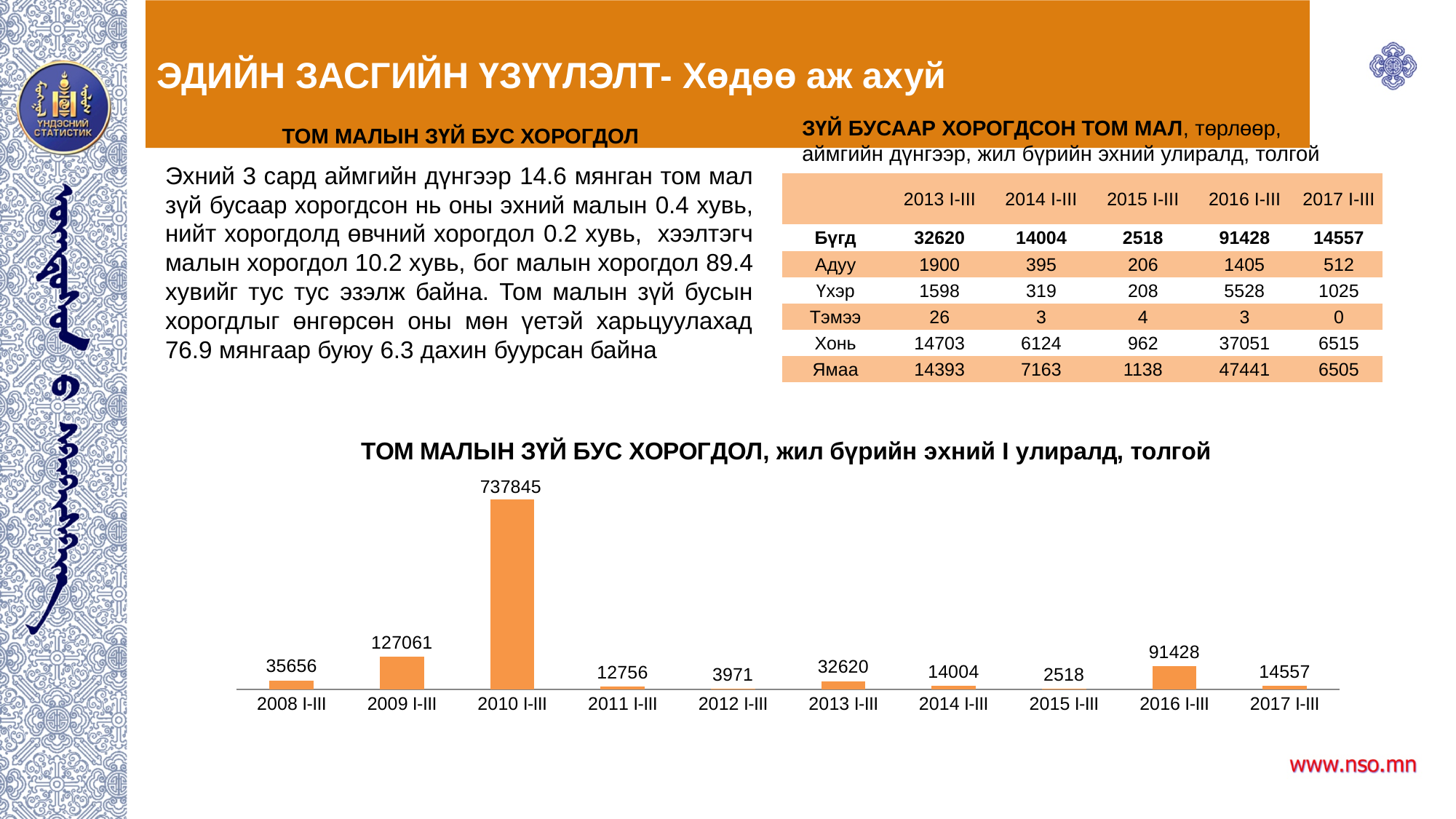
Does the value rise or fall from 2016 I-III to 2017 I-III in the bar chart? Fall What is the value for 2010 I-III in the bar chart? 737845 How many periods are shown on the x axis of the bar chart? 10 What is the value for 2016 I-III in the bar chart? 91428 Which period has the highest value in the bar chart? 2010 I-III What is the difference between the values for 2009 I-III and 2008 I-III in the bar chart? 91405 What kind of chart is shown at the bottom of the slide? Bar chart What is the difference between the values for 2016 I-III and 2017 I-III in the bar chart? 76871 Which is larger in the bar chart, the value for 2013 I-III or 2014 I-III? 2013 I-III Which period has the lowest value in the bar chart? 2015 I-III What is the value for 2012 I-III in the bar chart? 3971 What is the title of the bar chart? ТОМ МАЛЫН ЗҮЙ БУС ХОРОГДОЛ, жил бүрийн эхний I улиралд, толгой